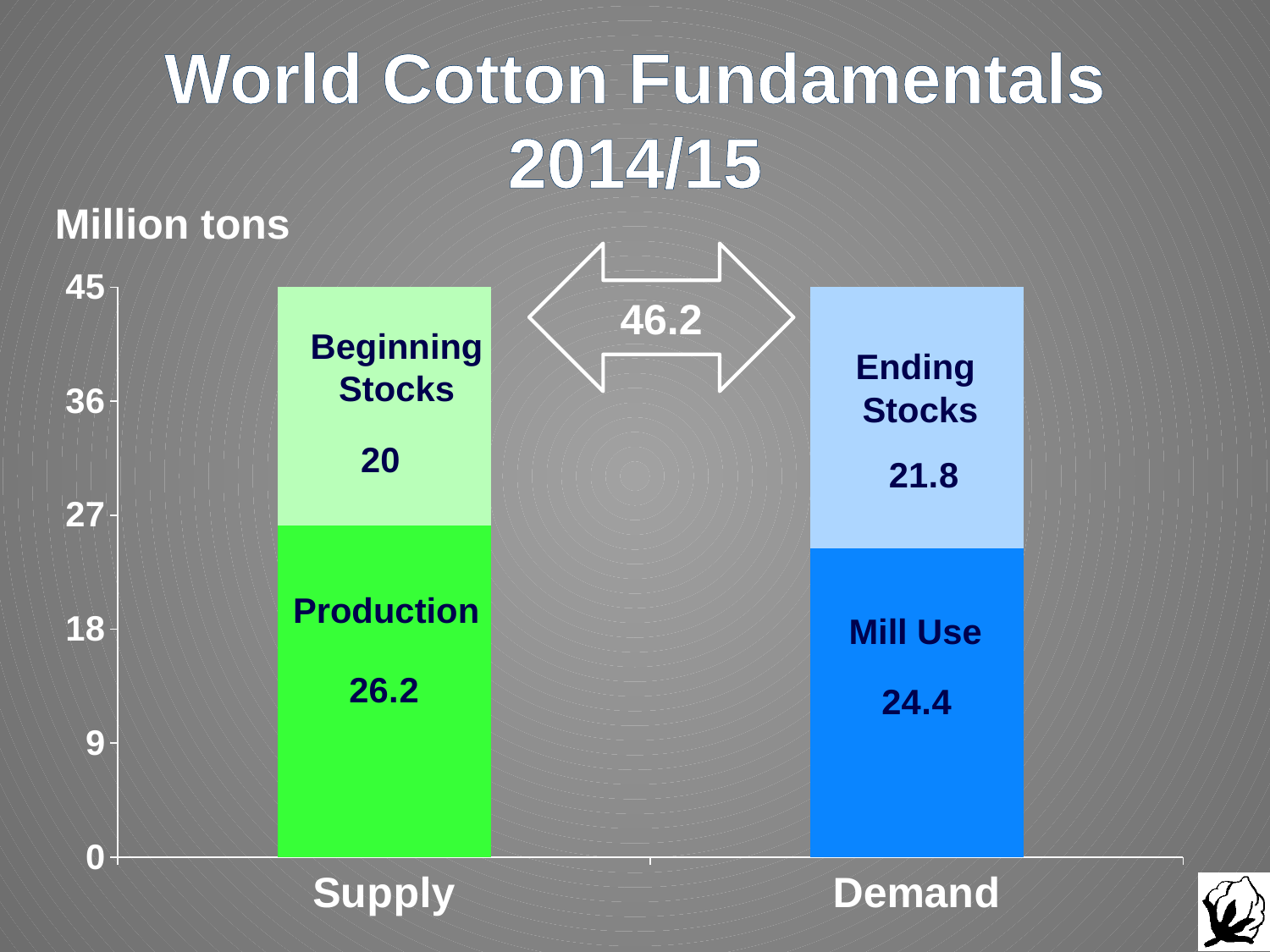
What is the value of Mill Use in the Demand bar? 24.4 What is the value of Ending Stocks in the Demand bar? 21.8 What is the total of the Demand bar (Mill Use plus Ending Stocks)? 46.2 What kind of chart is shown on the slide? Stacked bar chart What unit is shown for the values on the chart? Million tons Which segment has the smallest value on the chart? Beginning Stocks What is the difference between Production and Mill Use? 1.8 Which is larger, Production or Mill Use? Production What is the value of Production in the Supply bar? 26.2 What is the value of Beginning Stocks in the Supply bar? 20 What is the total of the Supply bar (Production plus Beginning Stocks)? 46.2 What is the difference between Ending Stocks and Beginning Stocks? 1.8